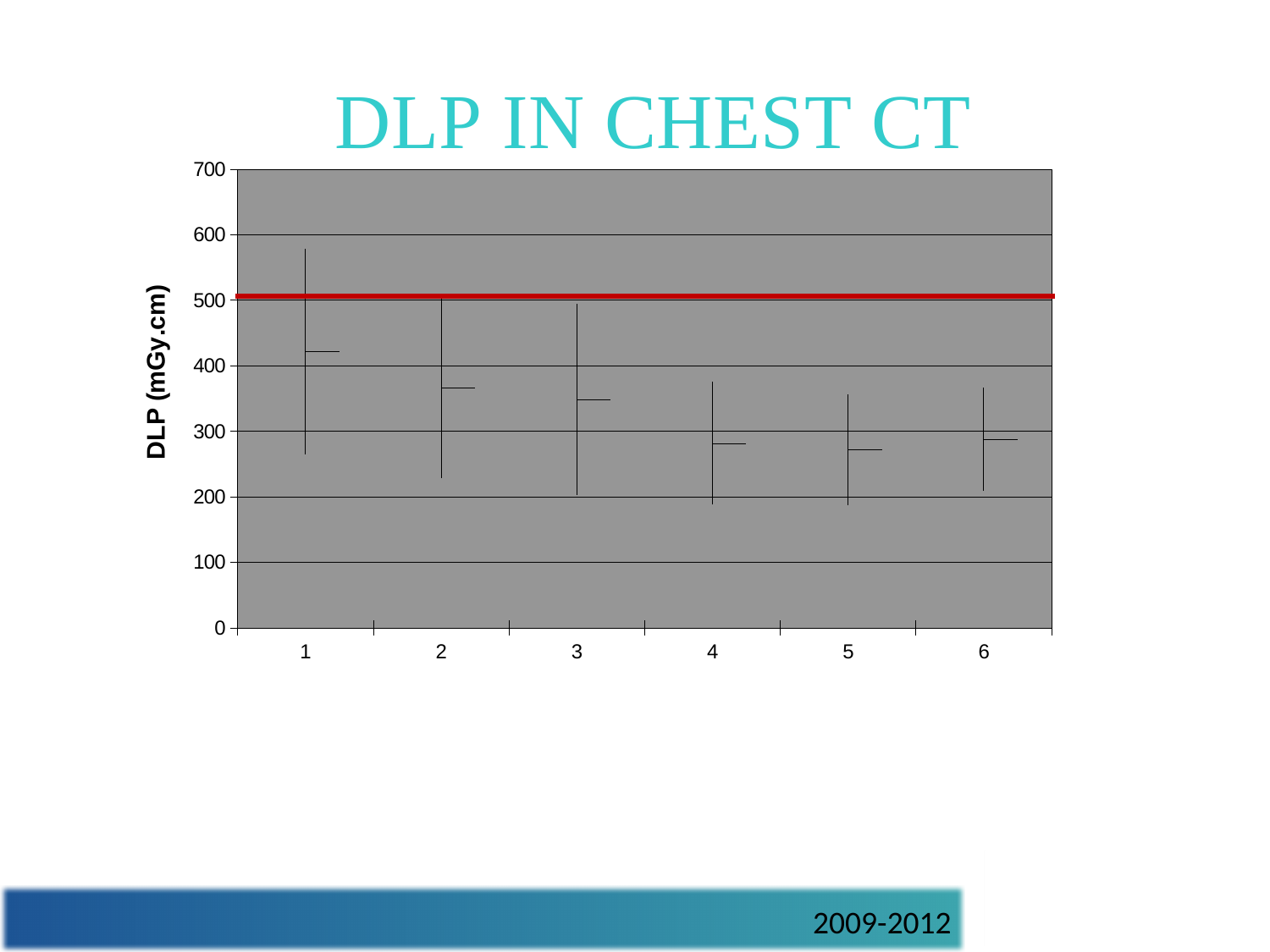
Which category has the highest marker value? 1 Is the top of the range line for category 4 greater or less than 400? less What is the label on the vertical axis? DLP (mGy.cm) Do the marker values generally rise or fall from category 1 to category 5? Fall Which has the larger marker value, category 1 or category 4? Category 1 Is the marker value for category 2 greater or less than 400? less How many categories are shown on the horizontal axis? 6 Is the marker value for category 4 greater or less than 300? less What is the title of the chart? DLP IN CHEST CT